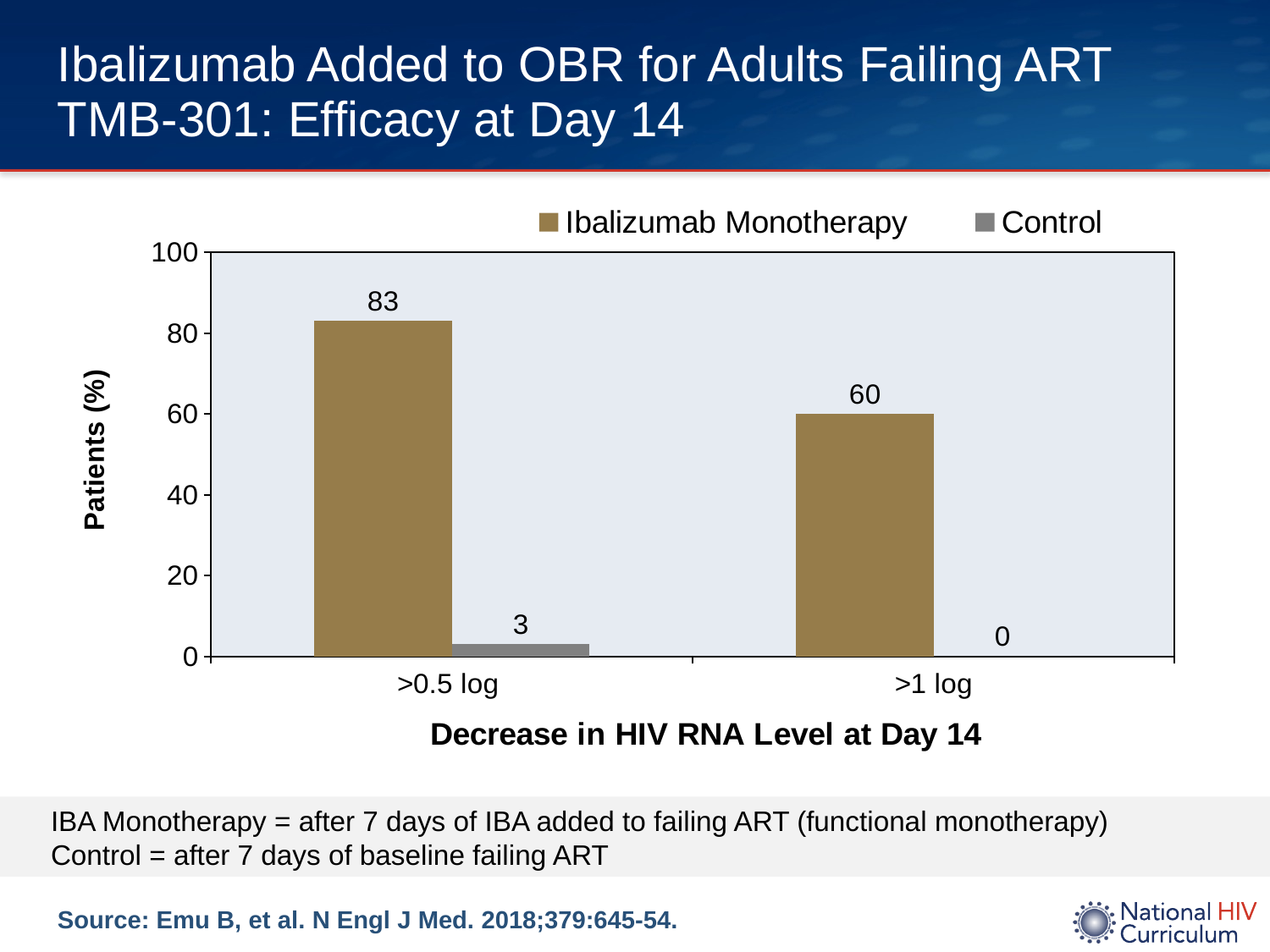
What is the label of the y axis? Patients (%) What percentage of patients in the Control group had a >0.5 log decrease in HIV RNA level? 3 Which category has the lowest value for the Control series? >1 log What percentage of patients in the Ibalizumab Monotherapy group had a >0.5 log decrease in HIV RNA level? 83 How many series does the legend list? 2 What percentage of patients in the Ibalizumab Monotherapy group had a >1 log decrease in HIV RNA level? 60 What percentage of patients in the Control group had a >1 log decrease in HIV RNA level? 0 Which is larger: the Ibalizumab Monotherapy value for >1 log or the Control value for >0.5 log? Ibalizumab Monotherapy value for >1 log What is the difference between the Ibalizumab Monotherapy and Control values for the >0.5 log category? 80 Which category has the highest value for the Ibalizumab Monotherapy series? >0.5 log What is the difference between the Ibalizumab Monotherapy values for >0.5 log and >1 log? 23 What kind of chart is shown on the slide? Bar chart